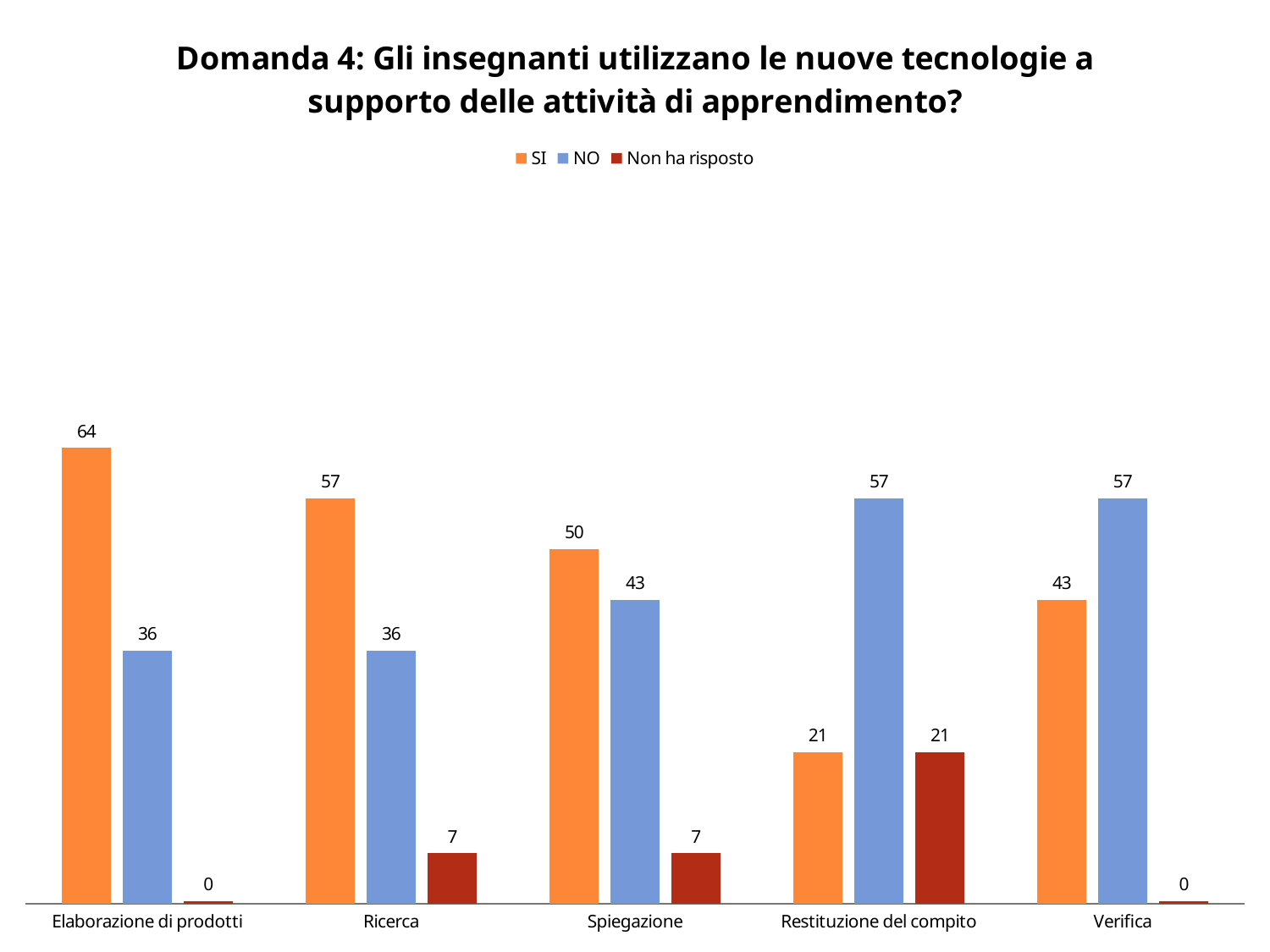
What is the Non ha risposto value for Restituzione del compito? 21 How many series does the legend list? 3 What is the total of the SI, NO and Non ha risposto values for Spiegazione? 100 What is the difference between the SI and NO values for Ricerca? 21 Which category has the highest SI value? Elaborazione di prodotti How many categories are shown on the x axis? 5 For Verifica, which is larger, the SI value or the NO value? NO Which category has the lowest SI value? Restituzione del compito Which series is shown in dark red in the legend? Non ha risposto What is the NO value for Spiegazione? 43 What kind of chart is shown on the slide? Bar chart What is the SI value for Elaborazione di prodotti? 64